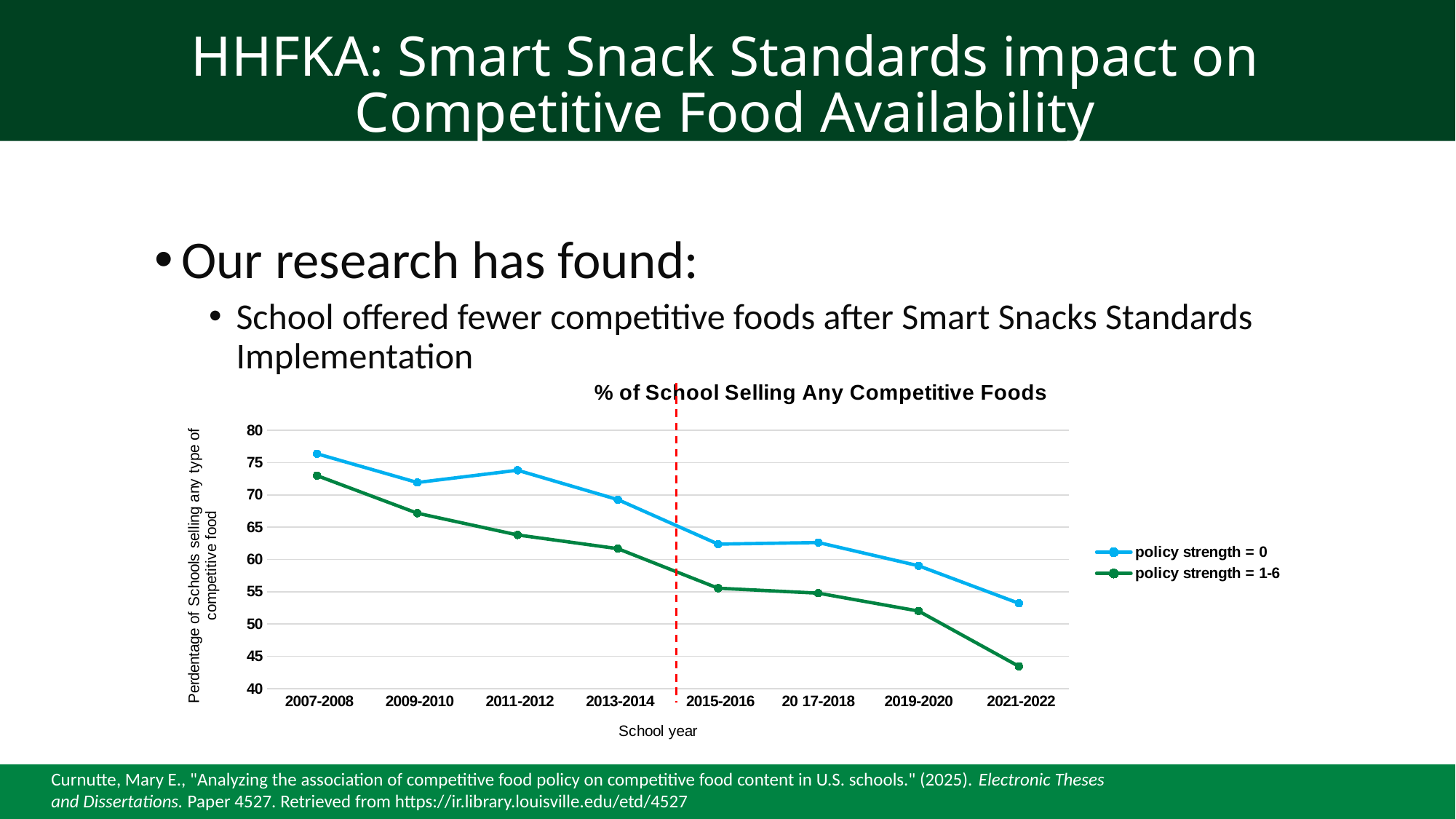
How many series does the chart's legend list? 2 In which school year is the value for policy strength = 0 highest? 2007-2008 How many school years are plotted along the x axis of the chart? 8 In 2021-2022, which series has the larger value, policy strength = 0 or policy strength = 1-6? policy strength = 0 What is the title of the chart? % of School Selling Any Competitive Foods What kind of chart is shown on the slide? line chart Which series is drawn in green in the chart? policy strength = 1-6 Is the value for policy strength = 0 in 2007-2008 greater or less than 75? greater In which school year is the value for policy strength = 1-6 lowest? 2021-2022 Do the values for policy strength = 0 rise or fall from 2007-2008 to 2021-2022? fall Is the value for policy strength = 1-6 in 2015-2016 greater or less than 60? less Is the value for policy strength = 1-6 in 2021-2022 greater or less than 45? less